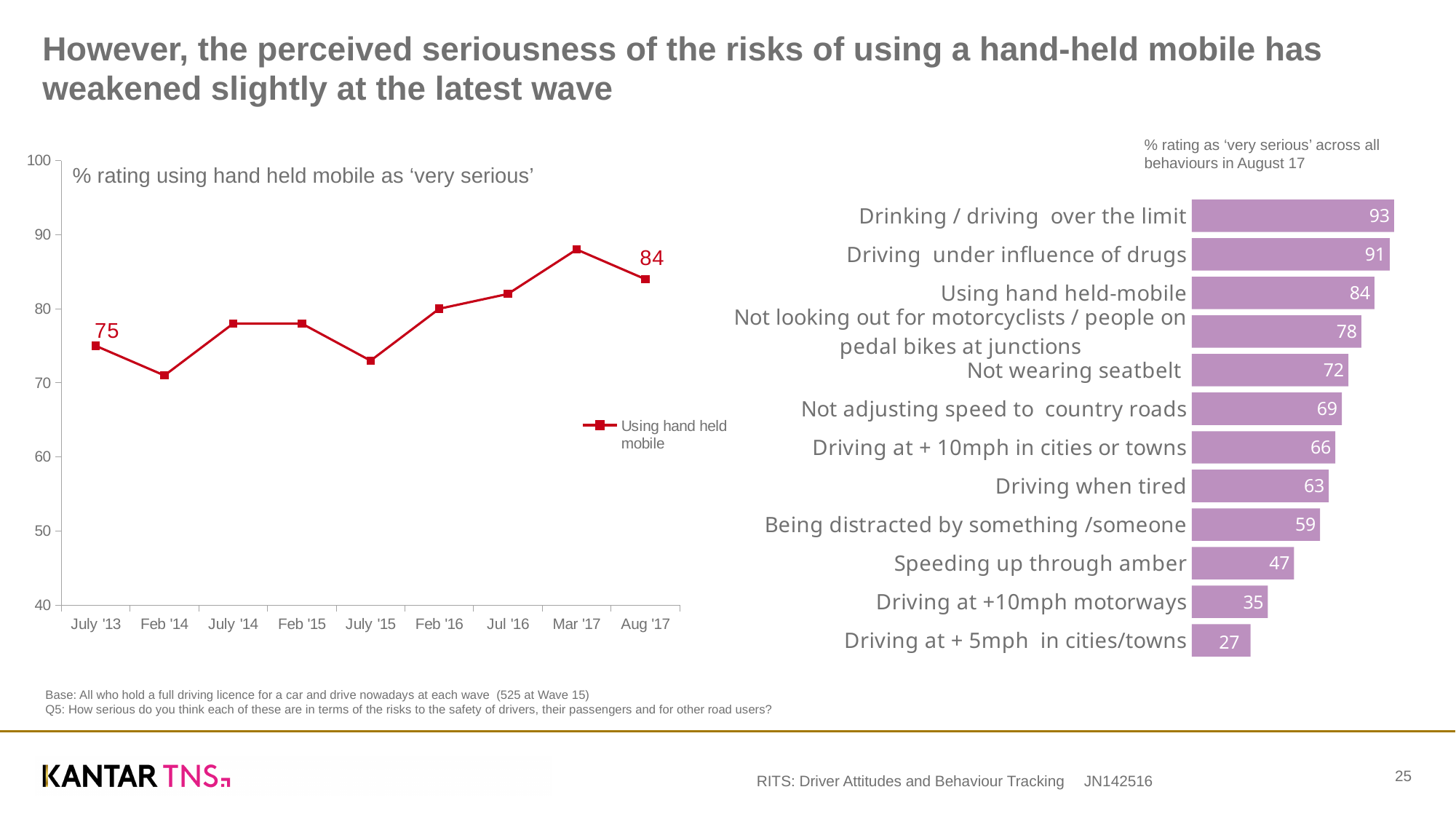
In the line chart on the left, how many time points are plotted on the x axis? 9 In the bar chart on the right, what is the difference between Driving under influence of drugs and Driving when tired? 28 In the bar chart on the right, which behaviour has the lowest % rating as 'very serious'? Driving at + 5mph in cities/towns In the bar chart on the right, how many behaviours are shown? 12 In the line chart on the left, what is the value for Aug '17? 84 In the line chart on the left, what is the value for July '13? 75 In the bar chart on the right, which behaviour has the highest % rating as 'very serious'? Drinking / driving over the limit In the bar chart on the right, what is the value for Not wearing seatbelt? 72 In the line chart on the left, what is the difference between the Aug '17 value and the July '13 value? 9 In the line chart on the left, what series does the legend list? Using hand held mobile In the line chart on the left, is the value for Feb '14 greater or less than 80? less In the line chart on the left, is the value for Mar '17 greater or less than 80? greater